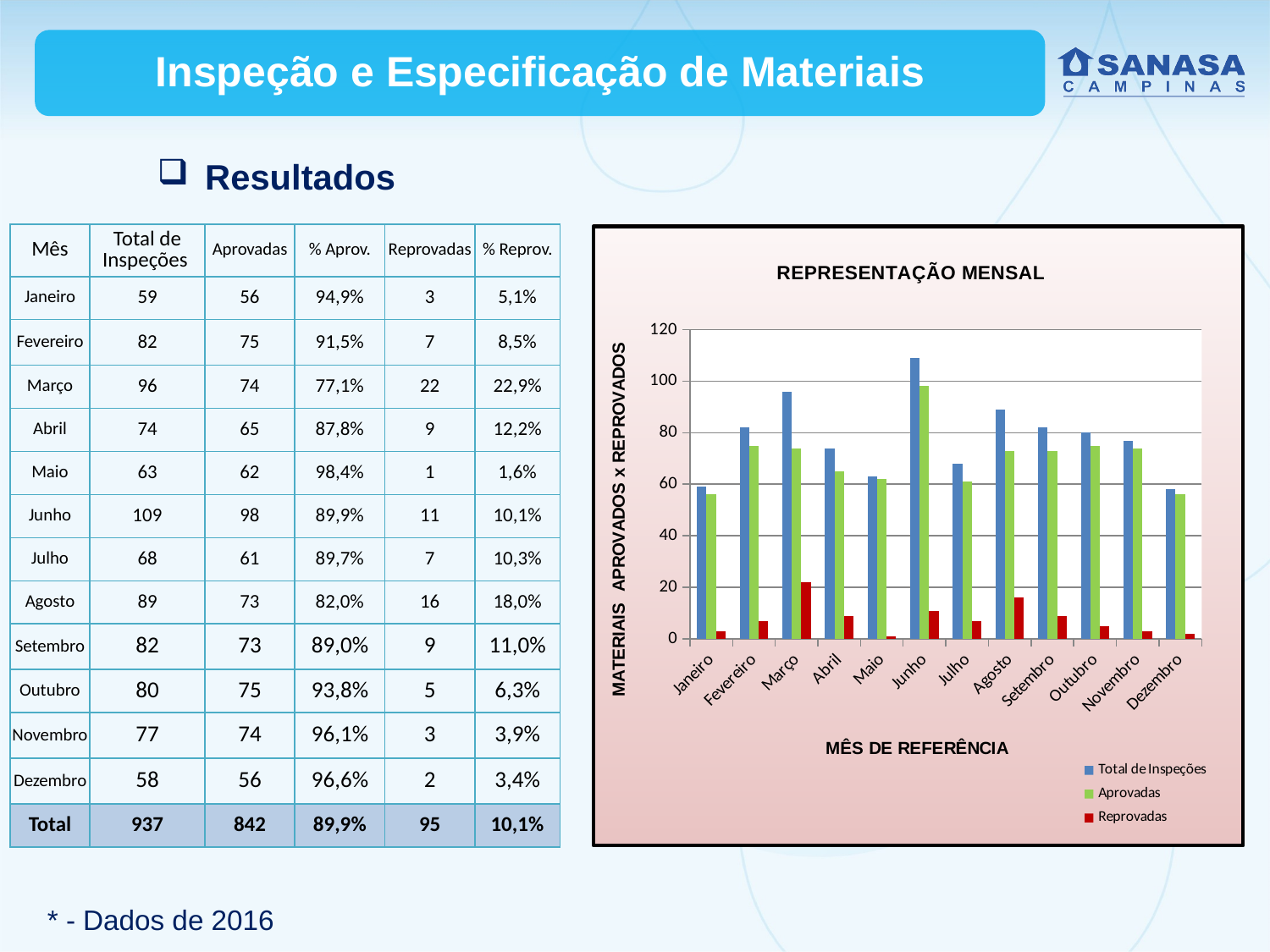
Is the Reprovadas value for Agosto greater or less than 20? less Which month has the larger Total de Inspeções value, Agosto or Julho? Agosto What is the difference between Total de Inspeções and Aprovadas for Junho? 11 How many series does the chart legend list? 3 Which month has the highest value for Reprovadas? Março What kind of chart is shown on the slide? bar chart How many months are shown along the x axis of the chart? 12 Is the Total de Inspeções value for Junho greater or less than 100? greater Do the Total de Inspeções values rise or fall from Setembro to Dezembro? fall What is the Total de Inspeções value for Junho? 109 What is the title of the chart? REPRESENTAÇÃO MENSAL Which month has the highest value for Total de Inspeções? Junho